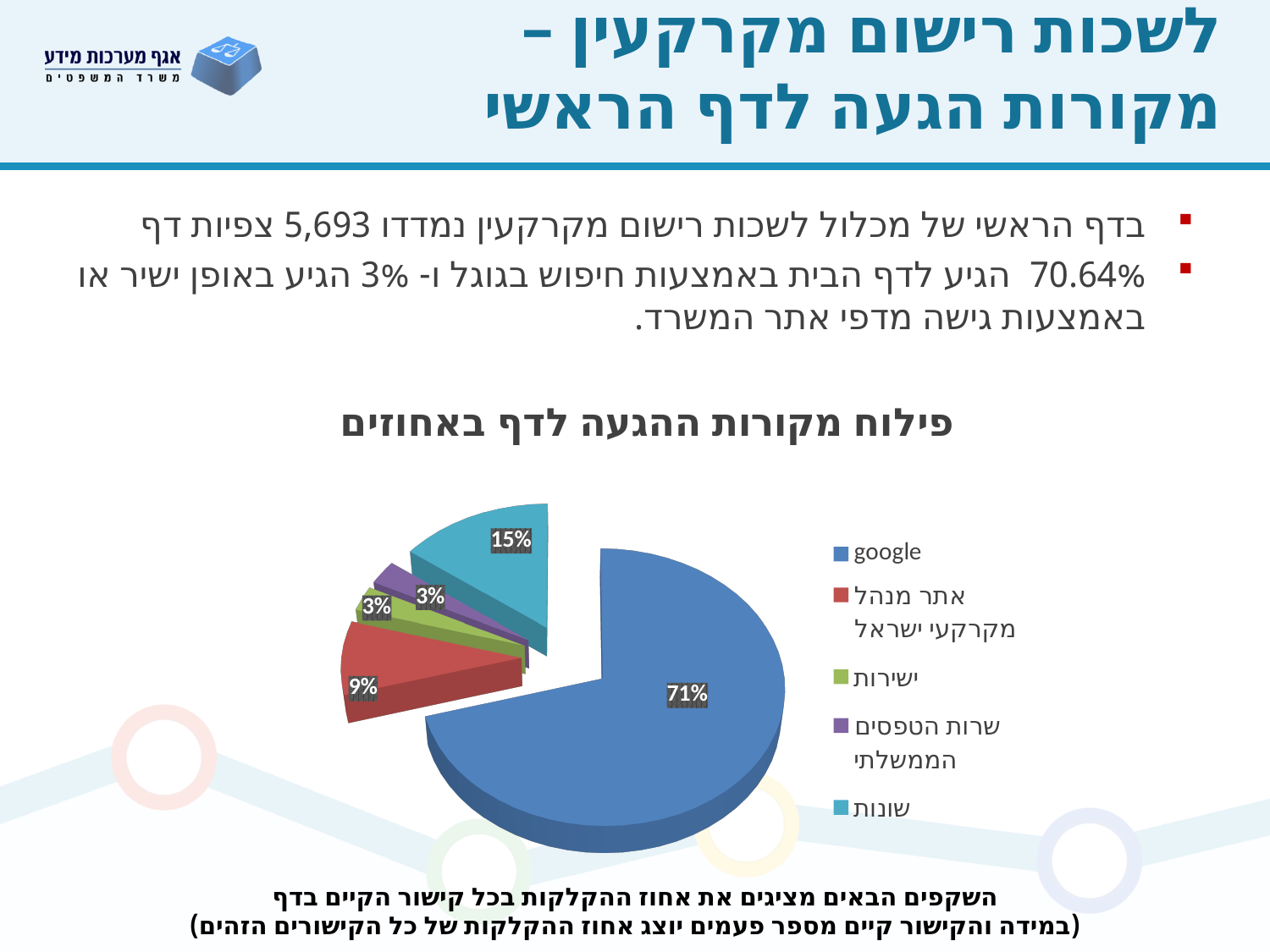
Which source has the largest share of the pie? google How many entries does the legend list? 5 What share of the pie does google have? 71% What share of the pie does אתר מנהל מקרקעי ישראל have? 9% Which is larger, the share for שונות or the share for אתר מנהל מקרקעי ישראל? שונות How many slices does the pie chart have? 5 What share of the pie does שרות הטפסים הממשלתי have? 3% What is the difference in percentage points between google and שונות? 56 What share of the pie does שונות have? 15% What share of the pie does ישירות have? 3% What is the title of the chart? פילוח מקורות ההגעה לדף באחוזים What kind of chart is shown on the slide? pie chart